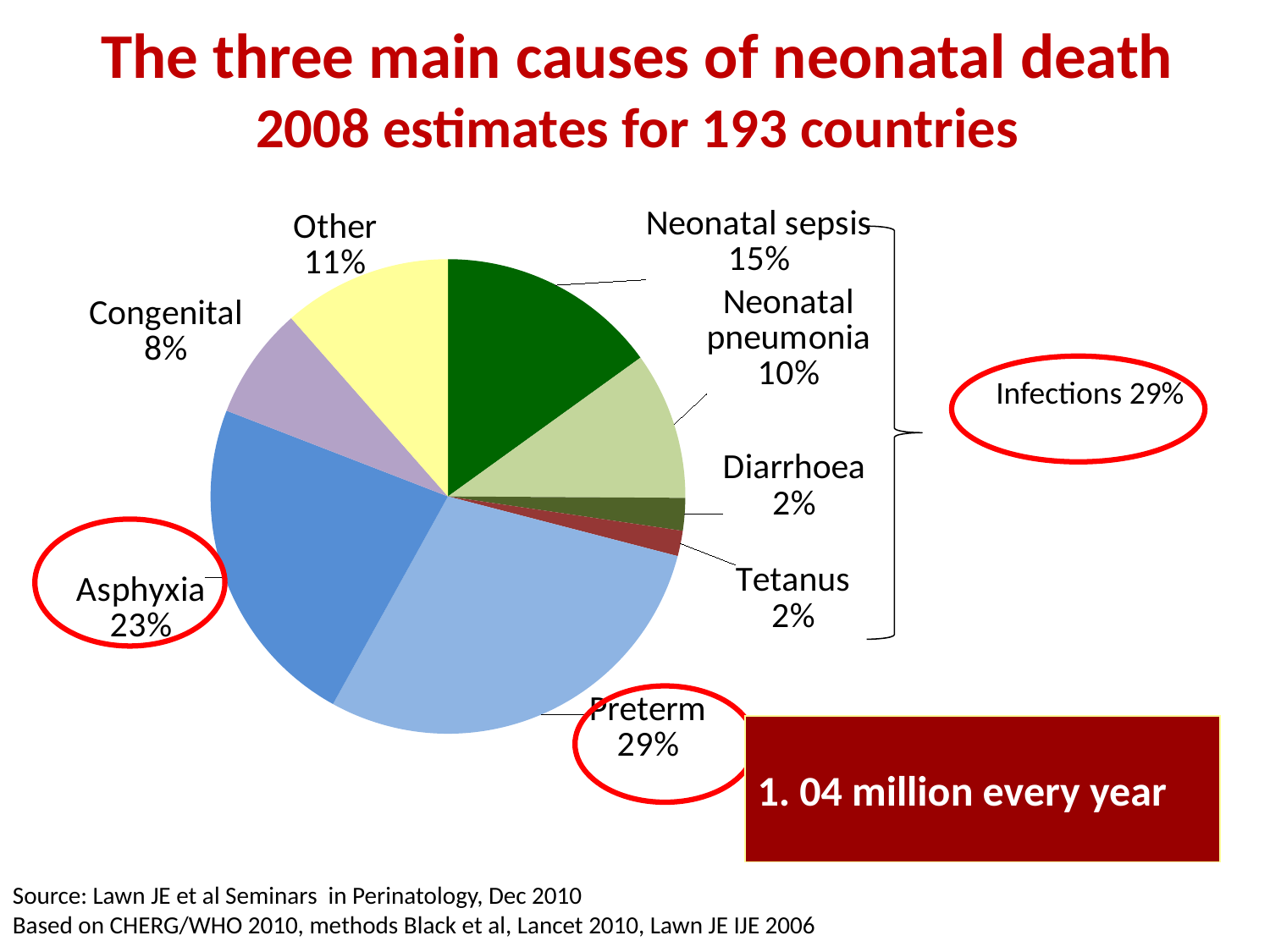
What is the title of the chart on the slide? The three main causes of neonatal death 2008 estimates for 193 countries What is the difference in percentage points between Preterm and Asphyxia? 6 What combined percentage does the slide give for Infections? 29% What kind of chart is shown on the slide? pie chart What is the combined share of Neonatal sepsis and Neonatal pneumonia? 25% What percentage is shown for Congenital? 8% What percentage is shown for Neonatal sepsis? 15% How many slices does the pie chart have? 8 Which is larger, the share for Neonatal pneumonia or the share for Other? Other Which cause has the largest slice of the pie? Preterm What share of neonatal deaths is attributed to Asphyxia? 23% What share of neonatal deaths is attributed to Preterm? 29%